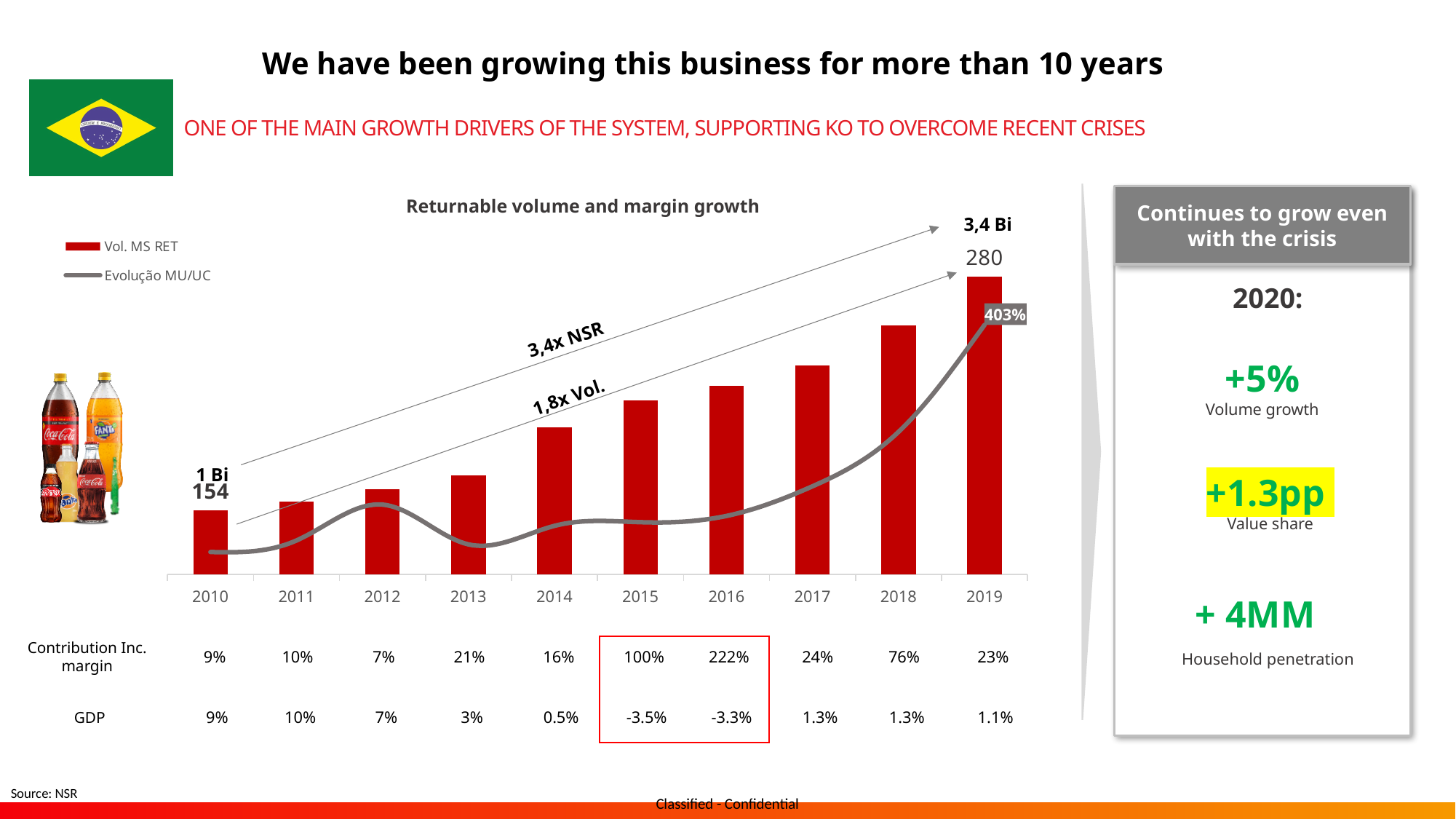
How many years are shown on the x axis of the 'Returnable volume and margin growth' chart? 10 What is the Vol. MS RET value labelled on the 2019 bar? 280 Which year has the shortest Vol. MS RET bar? 2010 Which year has the tallest Vol. MS RET bar? 2019 What percentage is labelled at the 2019 end of the Evolução MU/UC line? 403% What is the difference between the labelled Vol. MS RET values for 2019 and 2010? 126 In the table below the chart, what is the Contribution Inc. margin for 2016? 222% How many series does the legend of the 'Returnable volume and margin growth' chart list? 2 Do the Vol. MS RET bars generally rise or fall from 2010 to 2019? Rise What are the two legend entries in the 'Returnable volume and margin growth' chart? Vol. MS RET and Evolução MU/UC What kind of chart is shown under the title 'Returnable volume and margin growth'? A bar chart with a line series What is the Vol. MS RET value labelled on the 2010 bar? 154